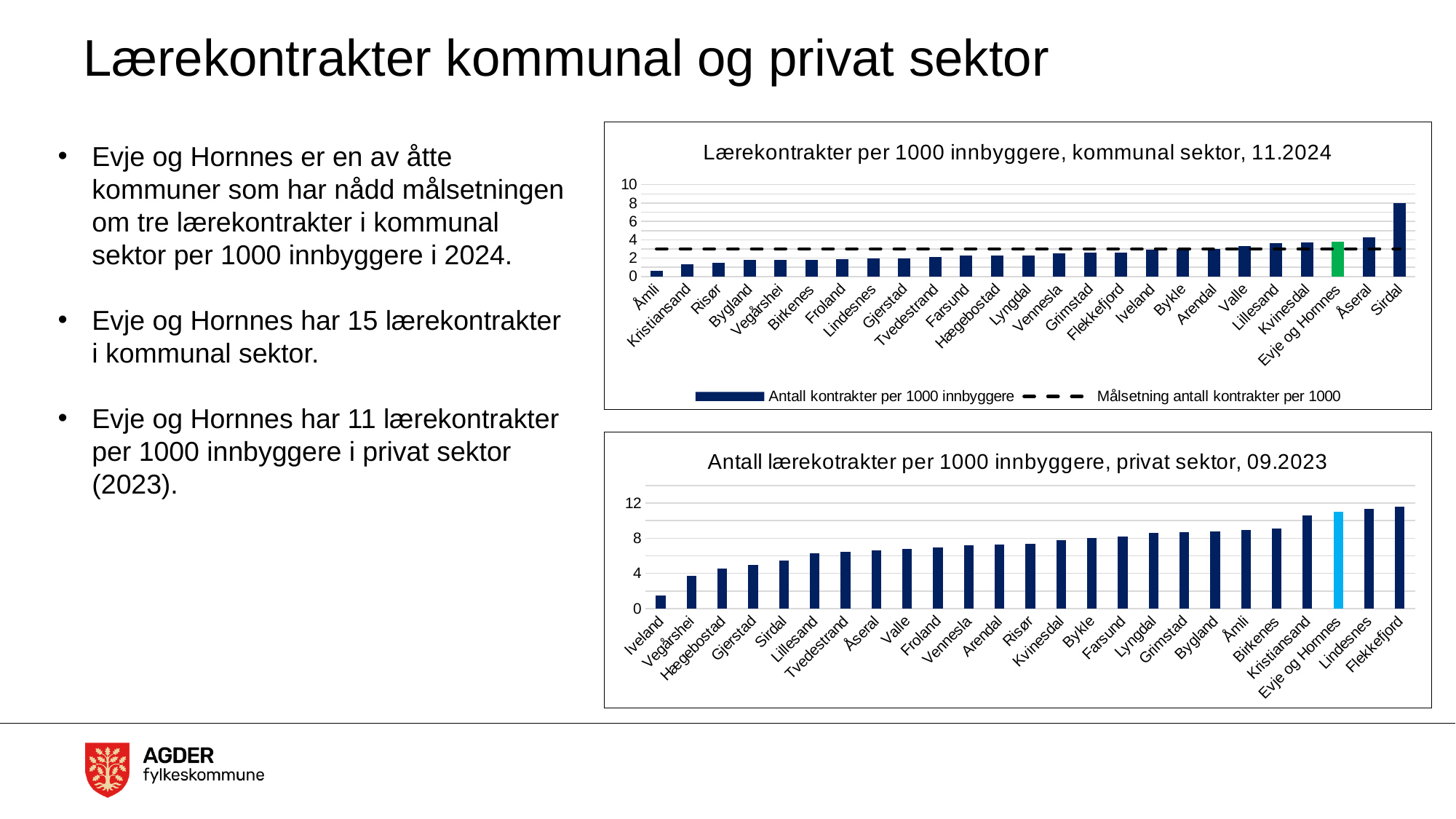
In the top chart (kommunal sektor), which municipality has the highest number of lærekontrakter per 1000 innbyggere? Sirdal In the bottom chart (privat sektor), is the value for Flekkefjord greater or less than 8? greater In the top chart (kommunal sektor), is the value for Sirdal greater or less than 6? greater In the bottom chart (privat sektor), which municipality has the highest value? Flekkefjord How many entries does the legend of the top chart (kommunal sektor) list? 2 In the top chart (kommunal sektor), which municipality has the lowest value? Åmli In the top chart (kommunal sektor), what colour is the bar for Evje og Hornnes? Green In the bottom chart (privat sektor), which municipality has the lowest value? Iveland In the bottom chart (privat sektor), do the values rise or fall from left to right along the x axis? Rise What kind of chart is the bottom chart (privat sektor)? Bar chart In the top chart (kommunal sektor), is the value for Åmli greater or less than 2? less How many municipalities are shown in the top chart (kommunal sektor)? 25